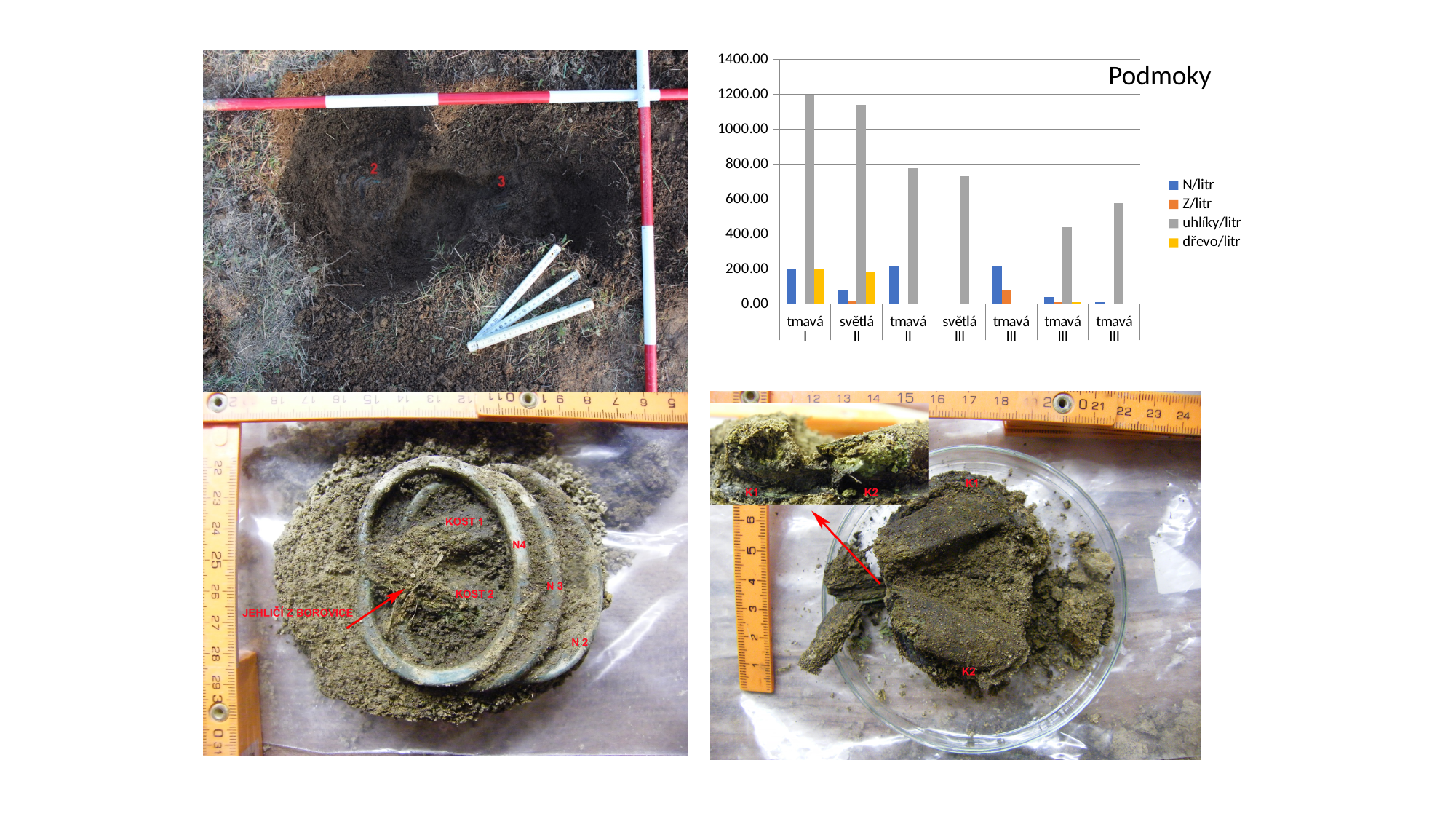
How many series does the chart legend list? 4 Which colour represents the uhlíky/litr series in the chart? gray Which is larger, the N/litr value for tmavá I or for světlá II? tmavá I Which category has the highest uhlíky/litr value? tmavá I Which is larger, the uhlíky/litr value for světlá II or for tmavá II? světlá II Is the uhlíky/litr value for tmavá I greater or less than 1000? greater Is the uhlíky/litr value for světlá III greater or less than 800? less What is the title of the chart? Podmoky What kind of chart is shown on the slide? bar chart How many categories are shown along the x axis of the chart? 7 Is the N/litr value for světlá II greater or less than 200? less